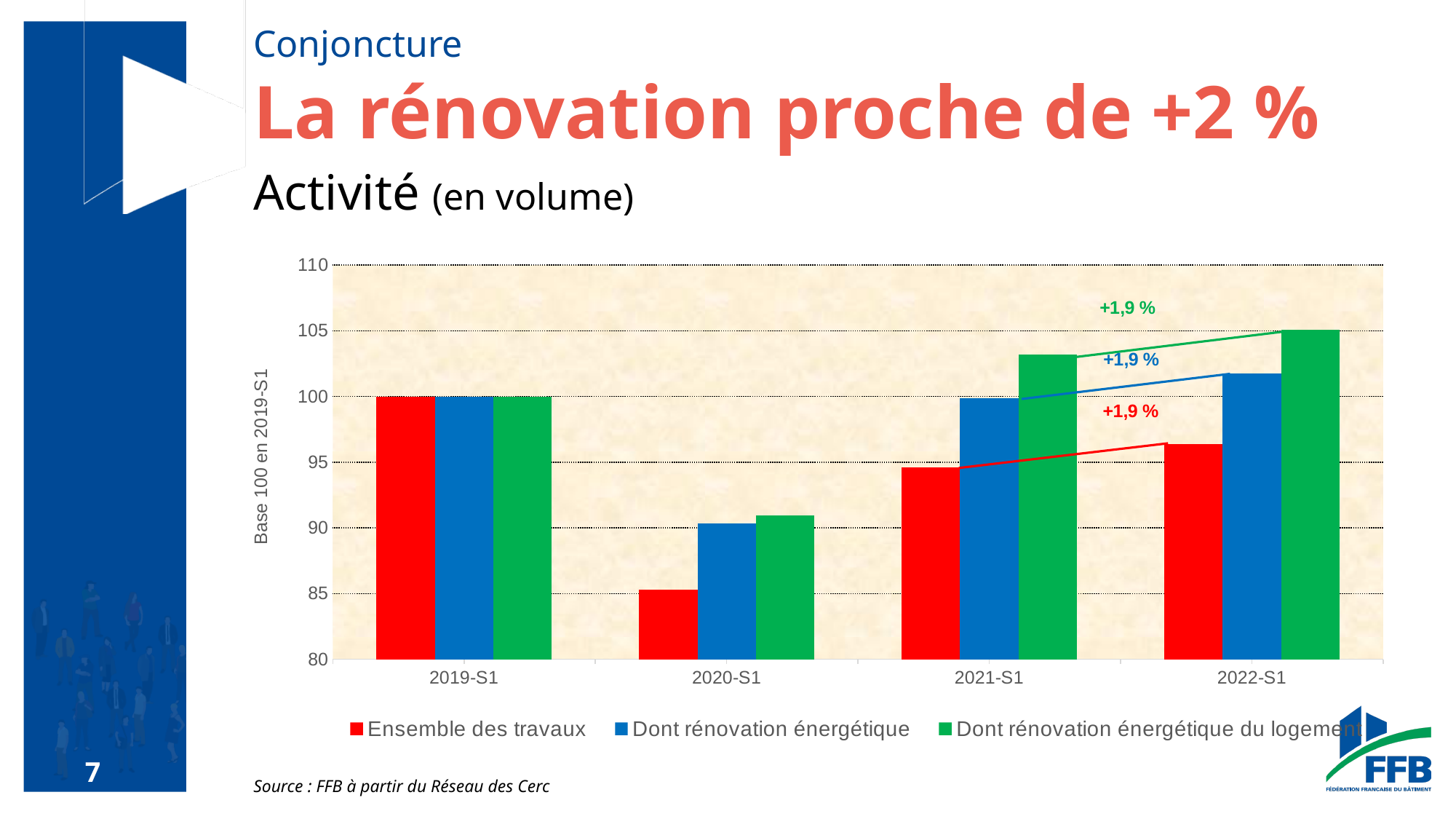
What is the value of Ensemble des travaux in 2019-S1? 100 What kind of chart is shown on the slide? bar chart How many periods are shown on the x axis? 4 What growth rate is annotated for each series between 2021-S1 and 2022-S1? +1,9 % Is the value for Dont rénovation énergétique du logement in 2021-S1 greater or less than 100? greater In which period is Dont rénovation énergétique du logement highest? 2022-S1 In 2021-S1, which is larger: Ensemble des travaux or Dont rénovation énergétique? Dont rénovation énergétique Is the value for Ensemble des travaux in 2020-S1 greater or less than 90? less In which period is Ensemble des travaux lowest? 2020-S1 Do the values for Dont rénovation énergétique du logement rise or fall from 2020-S1 to 2022-S1? rise How many series does the legend list? 3 Is the value for Ensemble des travaux in 2022-S1 greater or less than 100? less